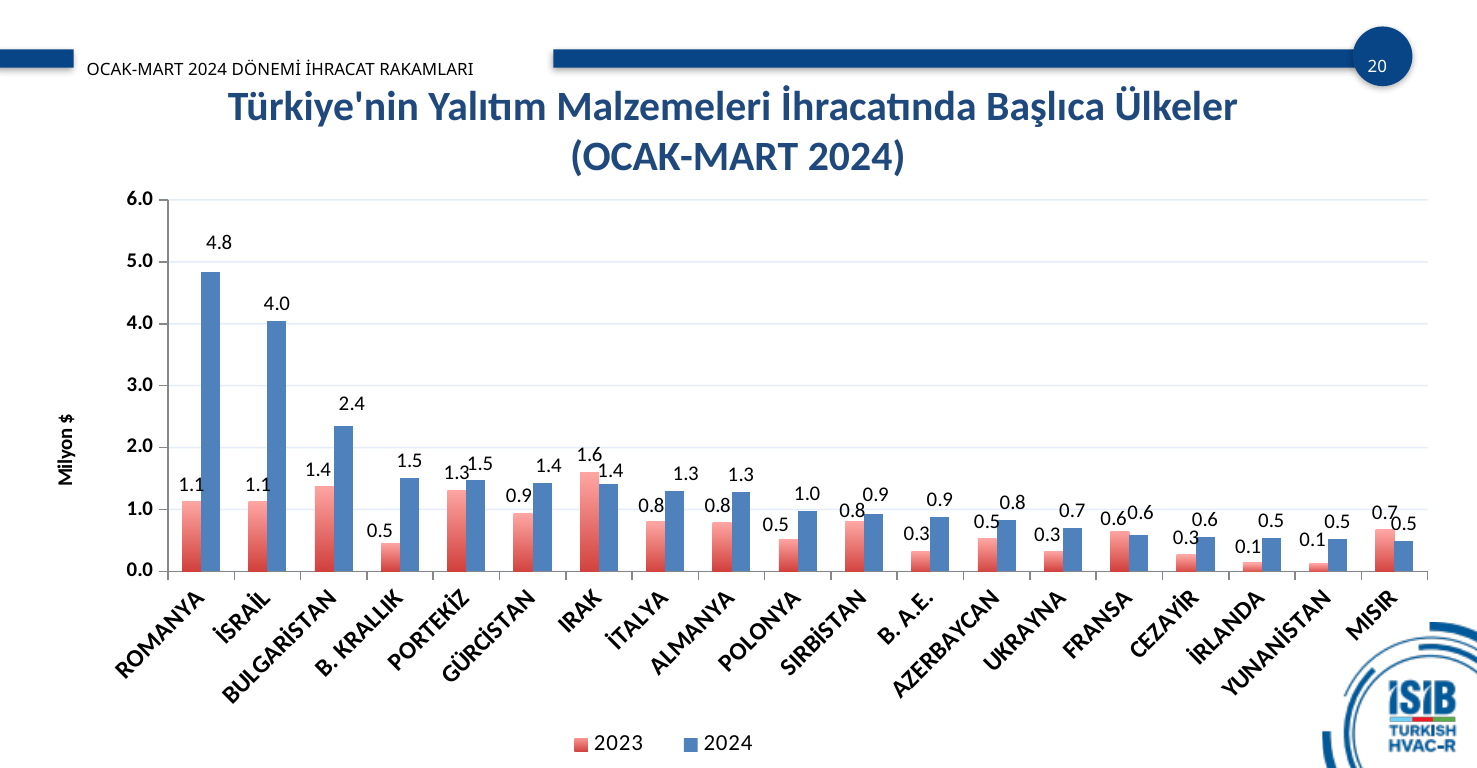
What kind of chart is shown on the slide? Bar chart Which is larger for MISIR, the 2023 value or the 2024 value? 2023 Which country has the highest 2024 value? ROMANYA How many series does the legend list? 2 What is the difference between the 2024 and 2023 values for İSRAİL? 2.9 What is the 2024 value for ROMANYA? 4.8 What is the 2023 value for IRAK? 1.6 What is the 2024 value for BULGARİSTAN? 2.4 Is the 2024 value for ROMANYA greater or less than 4.0? greater Which country has the highest 2023 value? IRAK What unit is shown on the y-axis label? Milyon $ How many countries are shown on the chart? 19